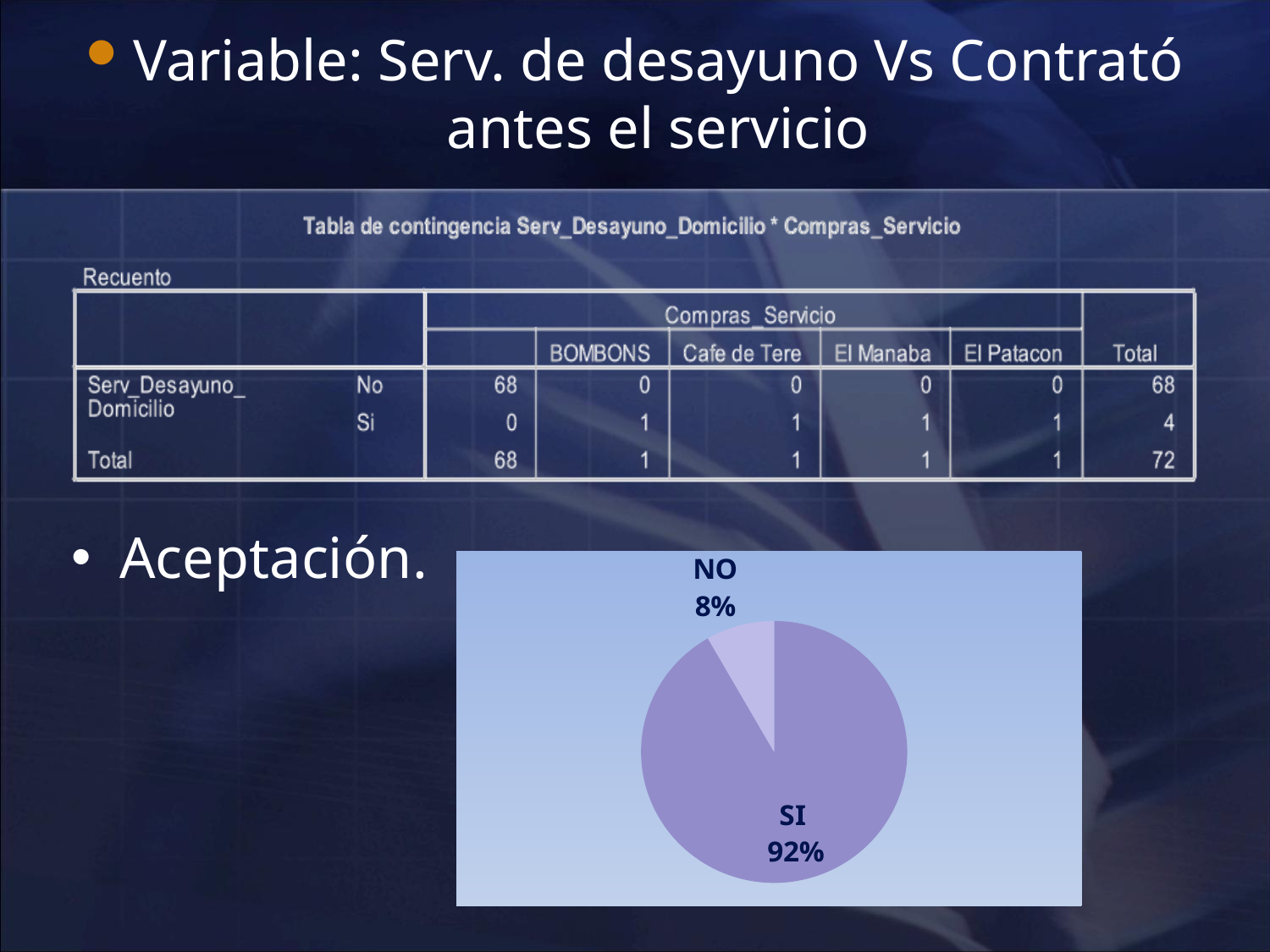
What kind of chart is shown on the slide? pie chart What is the difference in percentage points between the SI and NO slices? 84 What share of the pie chart does the NO slice represent? 8% Which is larger in the pie chart, SI or NO? SI Which slice of the pie chart is the largest? SI Is the share for NO greater or less than 10%? less How many slices does the pie chart have? 2 Is the share for SI greater or less than 50%? greater What are the labels of the two slices in the pie chart? NO and SI Which slice of the pie chart is the smallest? NO What share of the pie chart does the SI slice represent? 92%